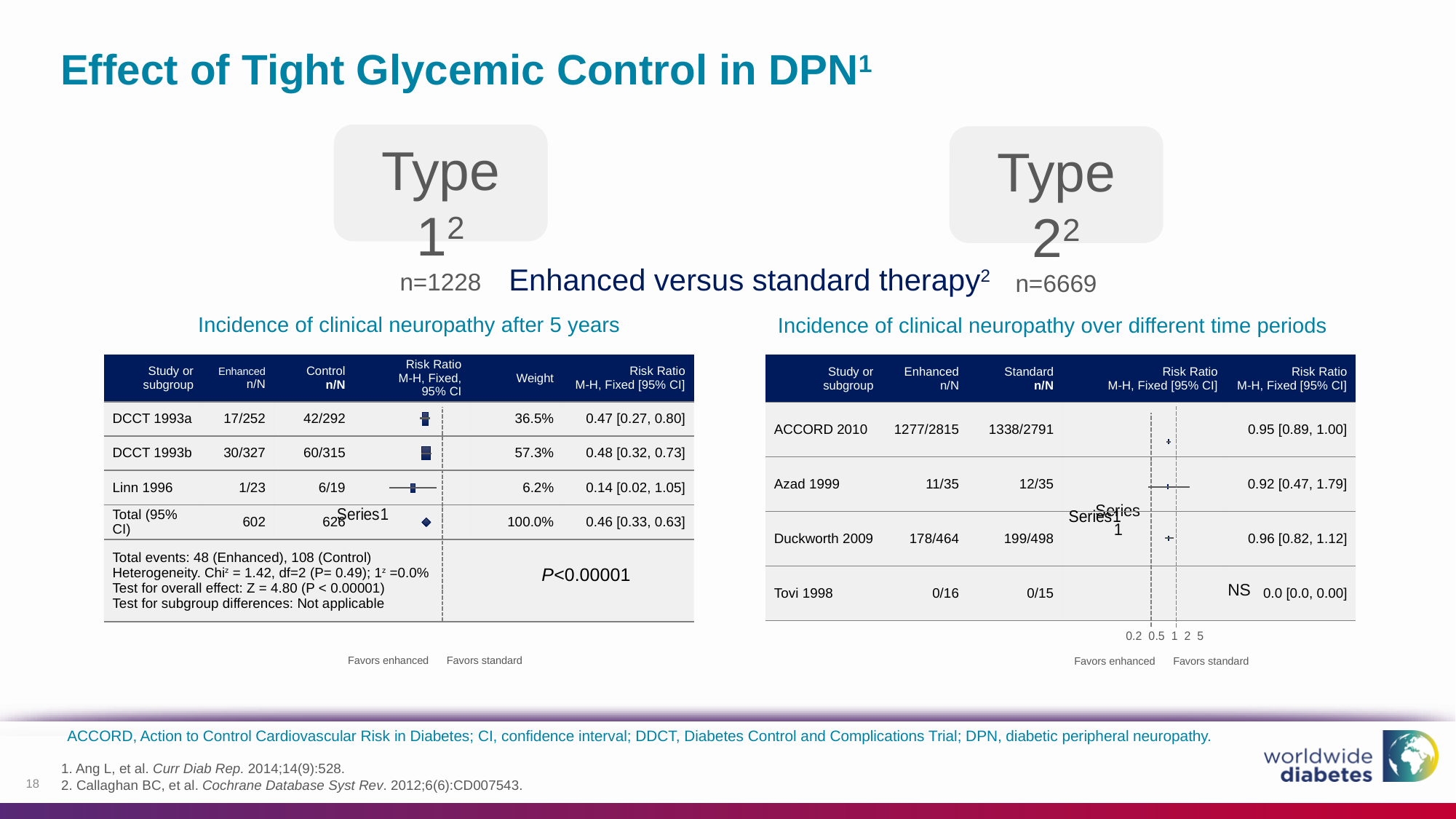
What kind of chart is used on this slide to display the risk ratios? Forest plot In the 'Incidence of clinical neuropathy over different time periods' chart, what is the risk ratio for ACCORD 2010? 0.95 [0.89, 1.00] In the 'Incidence of clinical neuropathy after 5 years' chart, what is the risk ratio for DCCT 1993b? 0.48 [0.32, 0.73] How many individual studies are plotted in the 'Incidence of clinical neuropathy after 5 years' chart (excluding the total)? 3 In the 'Incidence of clinical neuropathy after 5 years' chart, what is the difference in weight between DCCT 1993b and DCCT 1993a? 20.8% In the 'Incidence of clinical neuropathy over different time periods' chart, what is the Enhanced n/N for Duckworth 2009? 178/464 In the 'Incidence of clinical neuropathy after 5 years' chart, which study has the lowest risk ratio point estimate? Linn 1996 In the 'Incidence of clinical neuropathy after 5 years' chart, what is the total (95% CI) risk ratio? 0.46 [0.33, 0.63] How many studies are listed in the 'Incidence of clinical neuropathy over different time periods' chart? 4 In the 'Incidence of clinical neuropathy after 5 years' chart, what is the weight of DCCT 1993a? 36.5% In the 'Incidence of clinical neuropathy after 5 years' chart, which study has the highest weight? DCCT 1993b In the 'Incidence of clinical neuropathy over different time periods' chart, which study has the highest risk ratio point estimate? Duckworth 2009